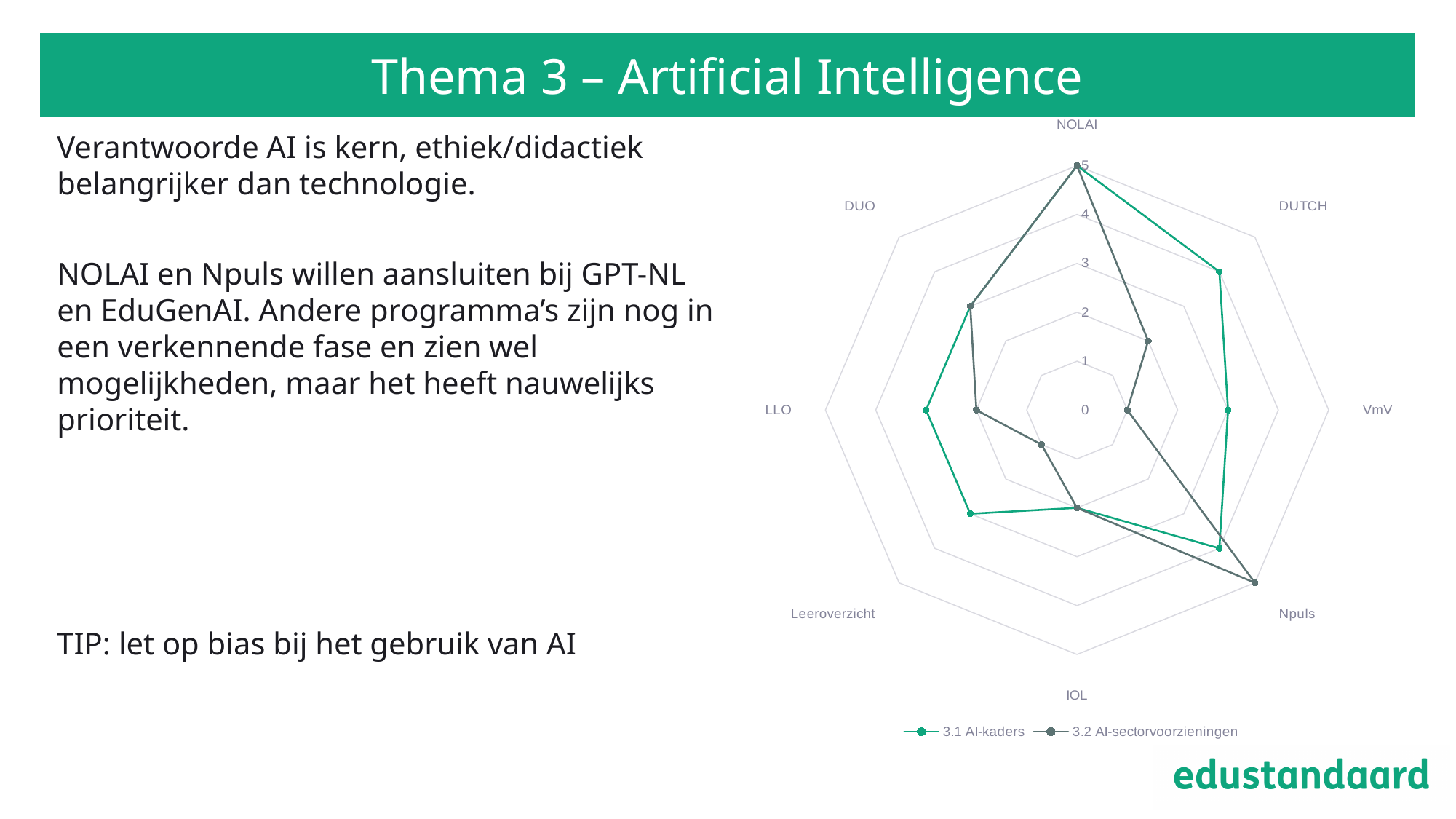
For DUTCH, which series has the larger value: 3.1 AI-kaders or 3.2 AI-sectorvoorzieningen? 3.1 AI-kaders How many series does the legend list? 2 What is the value for IOL in the 3.1 AI-kaders series? 2 What is the value for DUTCH in the 3.2 AI-sectorvoorzieningen series? 2 What kind of chart is shown on the slide? Radar chart How many categories (axes) does the radar chart have? 8 Which category has the highest value in the 3.1 AI-kaders series? NOLAI What is the difference between the 3.2 AI-sectorvoorzieningen and 3.1 AI-kaders values for Npuls? 1 What is the value for NOLAI in the 3.1 AI-kaders series? 5 What are the two series names listed in the legend? 3.1 AI-kaders and 3.2 AI-sectorvoorzieningen Which category has the lowest value in the 3.1 AI-kaders series? IOL What is the value for Npuls in the 3.2 AI-sectorvoorzieningen series? 5